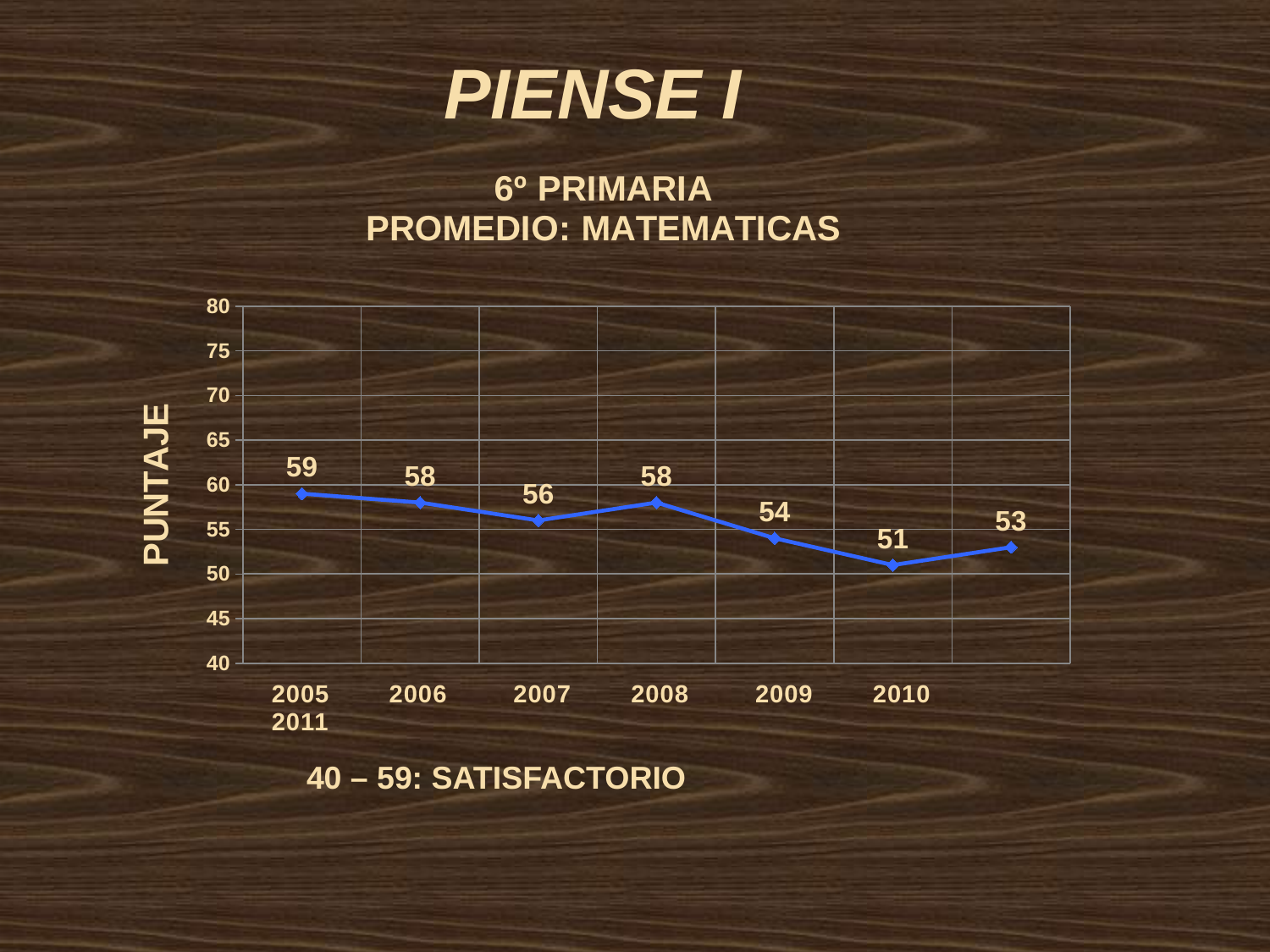
What is the PUNTAJE value for 2005? 59 What is the difference between the PUNTAJE values for 2005 and 2010? 8 What is the PUNTAJE value for 2011? 53 What is the PUNTAJE value for 2010? 51 What type of chart is shown on the slide? Line chart Which year has the lowest PUNTAJE value? 2010 What is the label of the y axis? PUNTAJE How many years are plotted on the chart? 7 Which year has a larger PUNTAJE value, 2008 or 2009? 2008 What is the PUNTAJE value for 2007? 56 Which year has the highest PUNTAJE value? 2005 Do the PUNTAJE values generally rise or fall from 2005 to 2010? Fall